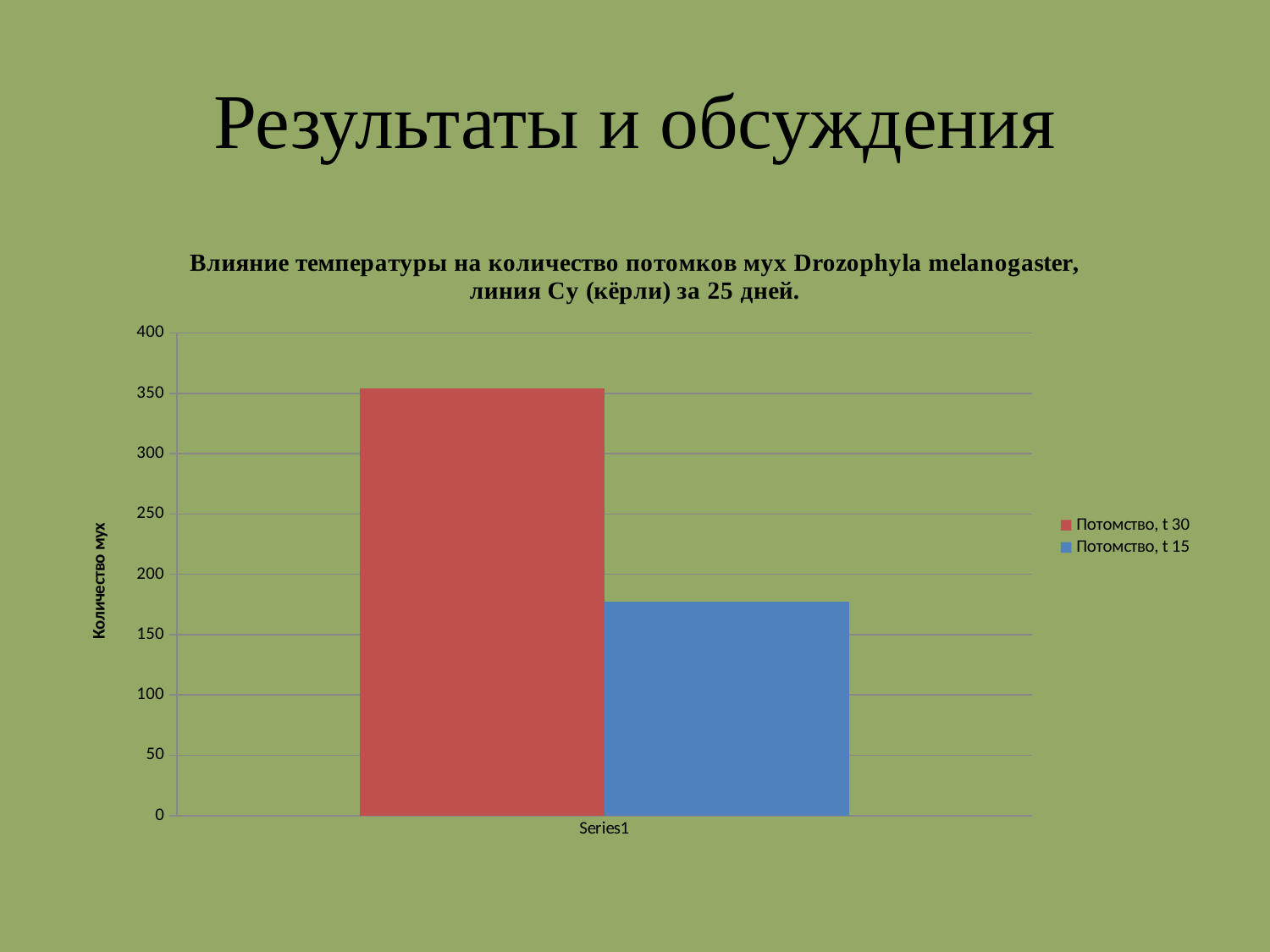
How many series does the legend list? 2 Which series has the taller bar, "Потомство, t 30" or "Потомство, t 15"? Потомство, t 30 Is the value for "Потомство, t 15" greater or less than 150? greater Is the value for "Потомство, t 15" greater or less than 200? less How many categories are shown on the x axis? 1 Is the value for "Потомство, t 30" greater or less than 400? less What kind of chart is shown on the slide? bar chart Which series has the lowest value? Потомство, t 15 Which series has the highest value? Потомство, t 30 What is the label of the vertical axis? Количество мух What colour is the bar for "Потомство, t 15"? blue